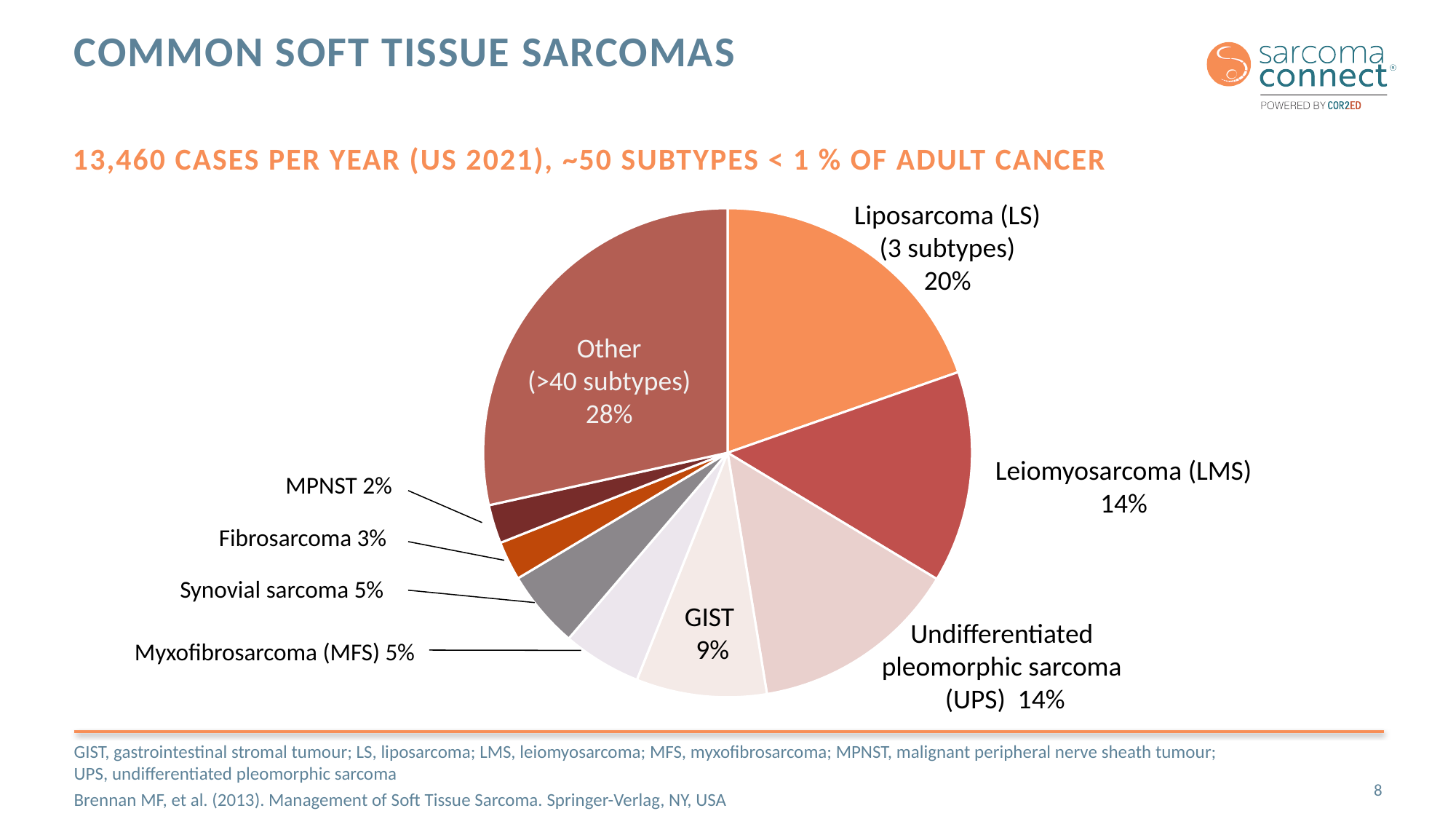
What percentage is shown for MPNST? 2% What percentage is shown for GIST? 9% How many subtypes does the Liposarcoma (LS) slice label say it includes? 3 subtypes What is the difference in percentage points between Other (>40 subtypes) and Liposarcoma (LS)? 8 How many slices does the pie chart have? 9 What kind of chart is shown on the slide? Pie chart Which is larger, the share for Leiomyosarcoma (LMS) or the share for GIST? Leiomyosarcoma (LMS) Which category has the smallest slice of the pie? MPNST Which category has the largest slice of the pie? Other (>40 subtypes) What is the combined percentage of Fibrosarcoma and Myxofibrosarcoma (MFS)? 8% What share of the pie does Liposarcoma (LS) represent? 20% What percentage is shown for Synovial sarcoma? 5%